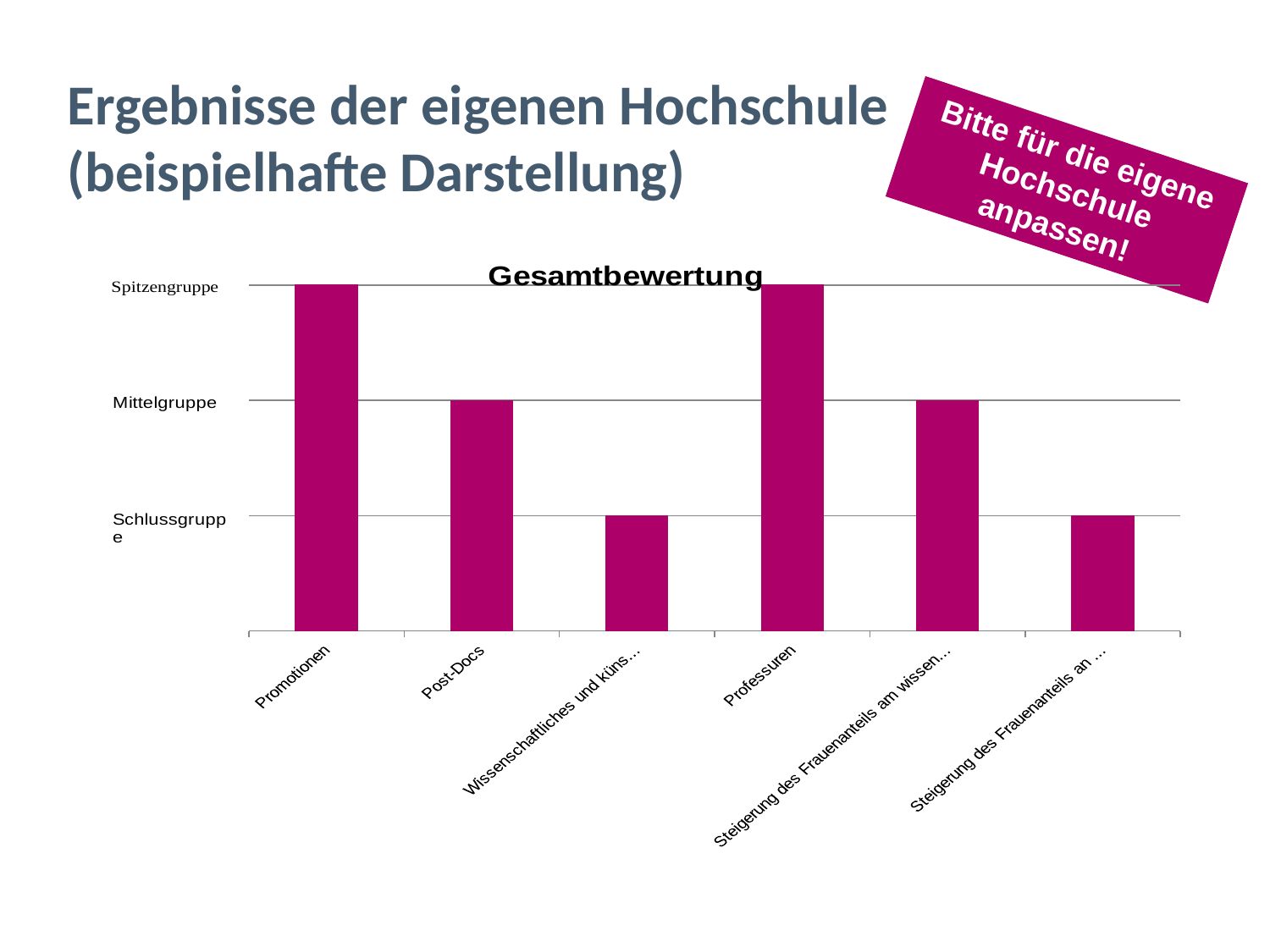
Which is rated lower, Post-Docs or the rightmost bar (Steigerung des Frauenanteils an ...)? Steigerung des Frauenanteils an ... Which group level does the bar for Post-Docs reach? Mittelgruppe How many categories (bars) does the chart show? 6 How many rating levels are labelled on the vertical axis? 3 Which group level does the bar for Professuren reach? Spitzengruppe Which group level does the rightmost bar (Steigerung des Frauenanteils an ...) reach? Schlussgruppe Which group level does the third bar from the left (Wissenschaftliches und küns...) reach? Schlussgruppe Which is rated higher, Promotionen or Post-Docs? Promotionen Which is rated higher, Post-Docs or Professuren? Professuren What is the title of the chart? Gesamtbewertung Which group level does the bar for Promotionen reach? Spitzengruppe What type of chart is shown on the slide? bar chart